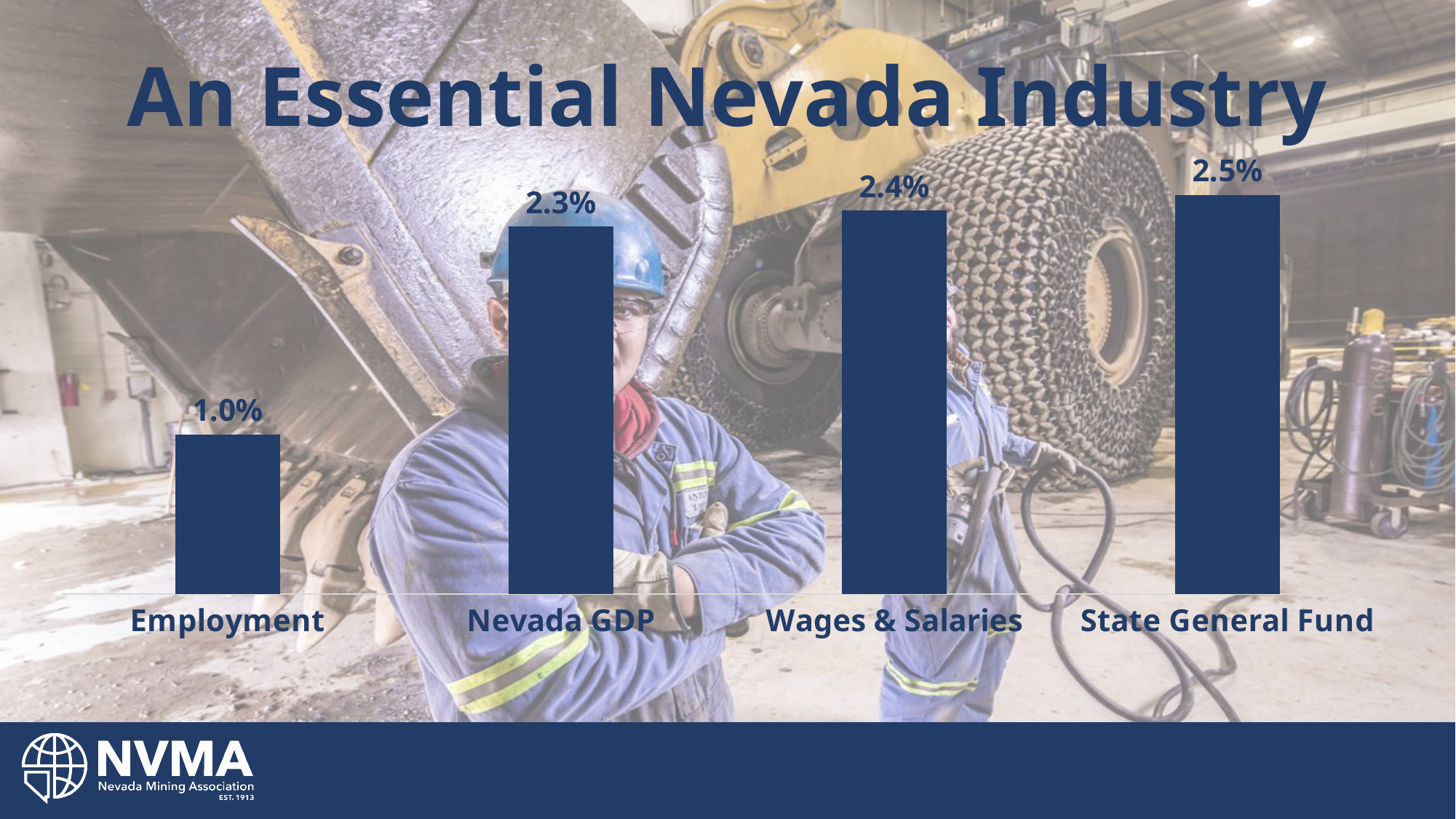
What kind of chart is shown on the slide? Bar chart Which category has the highest value? State General Fund Which is larger, the value for Nevada GDP or the value for Employment? Nevada GDP What is the difference between the Wages & Salaries value and the Nevada GDP value? 0.1% What is the value for State General Fund? 2.5% How many categories are shown in the chart? 4 What is the value for Wages & Salaries? 2.4% Which category has the lowest value? Employment Do the values rise or fall from left to right across the categories? Rise What is the value for Employment? 1.0% What is the difference between the State General Fund value and the Employment value? 1.5% What is the value for Nevada GDP? 2.3%